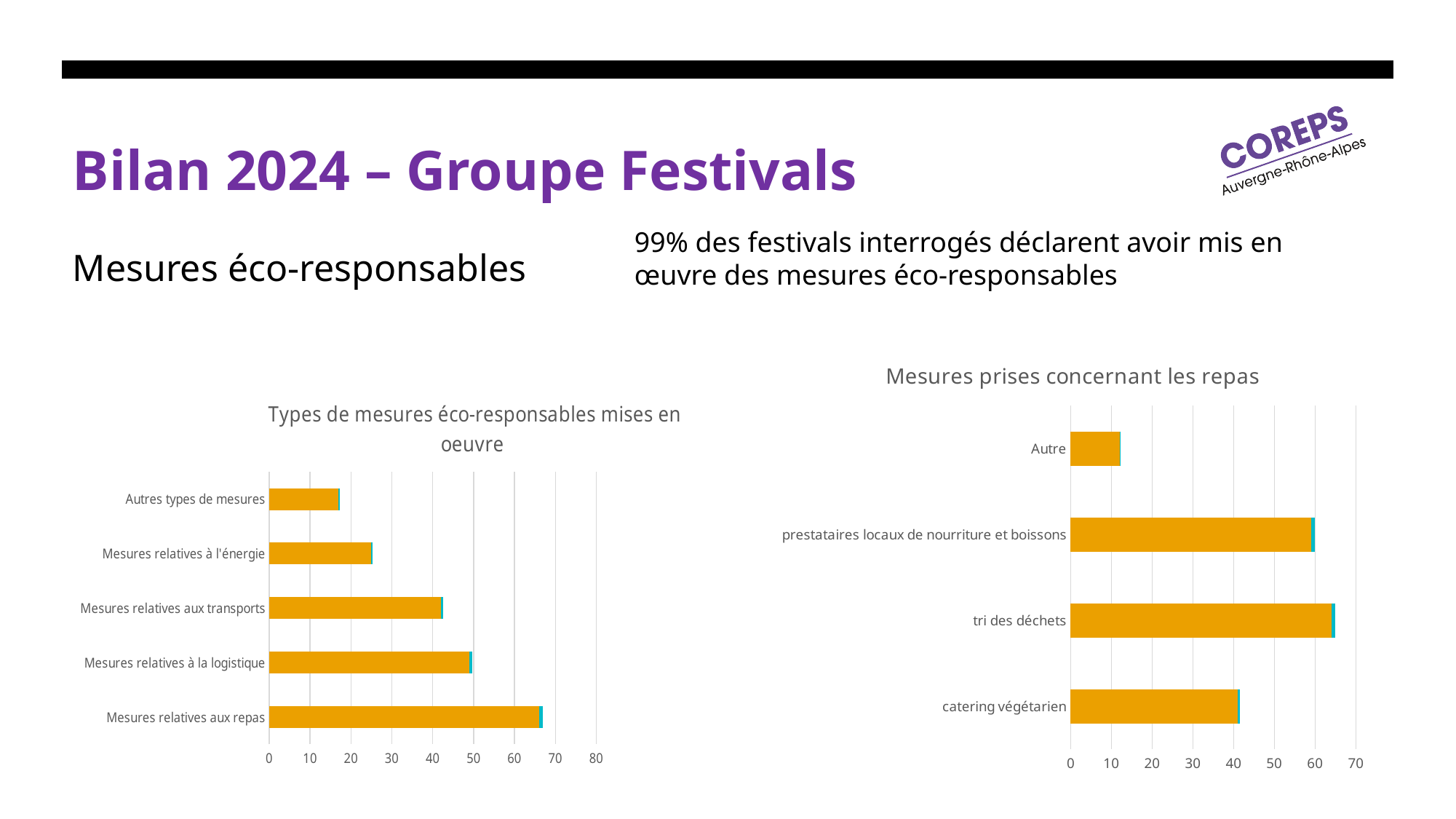
In the chart 'Types de mesures éco-responsables mises en oeuvre', which category has the highest value? Mesures relatives aux repas In the chart 'Mesures prises concernant les repas', how many categories are shown? 4 In the chart 'Types de mesures éco-responsables mises en oeuvre', is the value for 'Mesures relatives aux repas' greater or less than 60? greater In the chart 'Mesures prises concernant les repas', is the value for 'catering végétarien' greater or less than 50? less In the chart 'Types de mesures éco-responsables mises en oeuvre', which is larger: 'Mesures relatives à la logistique' or 'Mesures relatives aux transports'? Mesures relatives à la logistique In the chart 'Types de mesures éco-responsables mises en oeuvre', how many categories are shown? 5 In the chart 'Types de mesures éco-responsables mises en oeuvre', which category has the lowest value? Autres types de mesures In the chart 'Mesures prises concernant les repas', which category has the lowest value? Autre In the chart 'Mesures prises concernant les repas', is the value for 'prestataires locaux de nourriture et boissons' greater or less than 50? greater What kind of chart is 'Types de mesures éco-responsables mises en oeuvre'? bar chart In the chart 'Mesures prises concernant les repas', which category has the highest value? tri des déchets